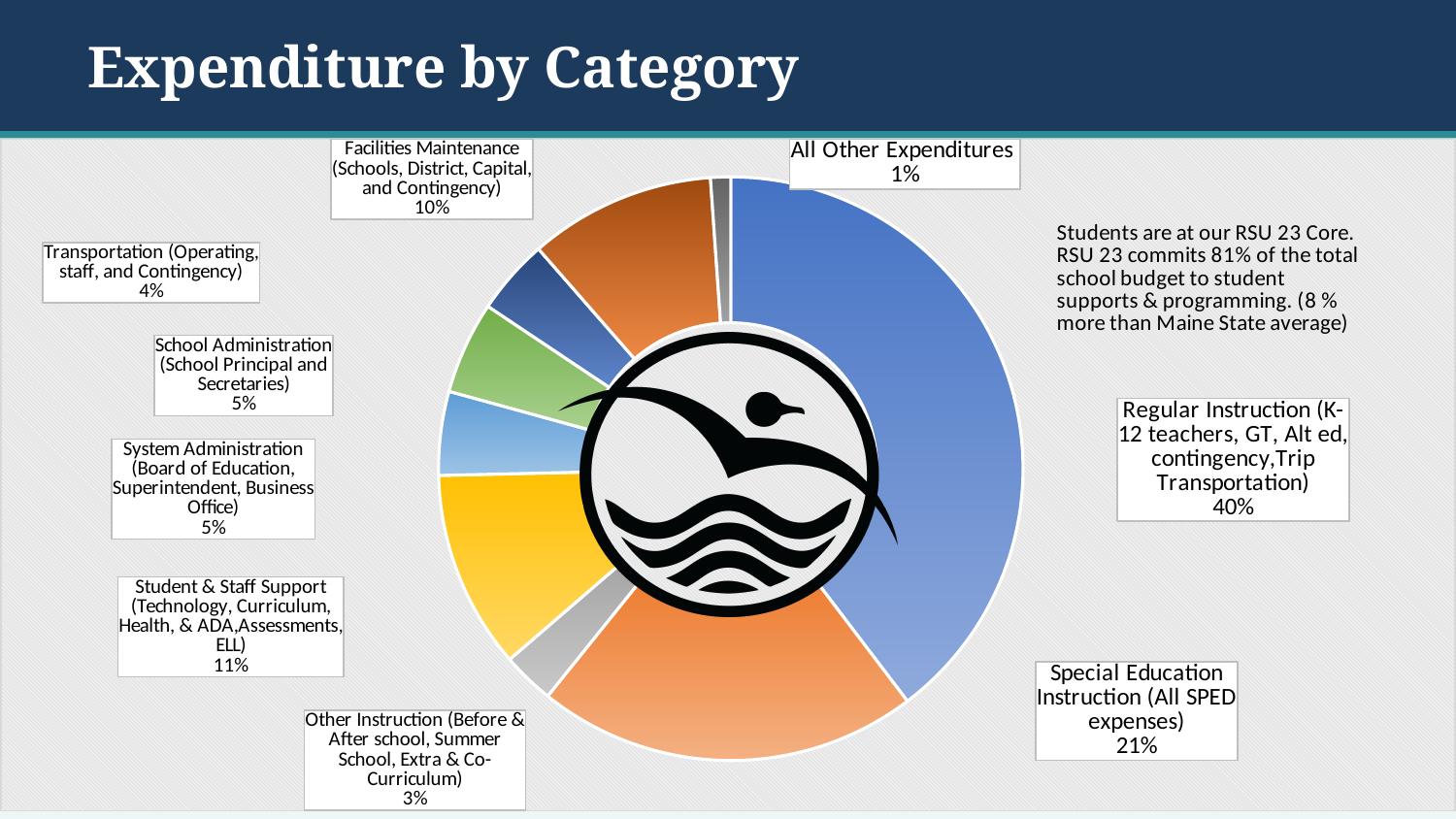
What is the combined percentage of School Administration and System Administration? 10% What kind of chart is shown on the slide? pie chart What percentage is shown for Facilities Maintenance (Schools, District, Capital, and Contingency)? 10% How many categories are shown in the pie chart? 9 Which is larger, the share for Transportation (Operating, staff, and Contingency) or the share for Other Instruction (Before & After school, Summer School, Extra & Co-Curriculum)? Transportation (Operating, staff, and Contingency) What is the title of the slide containing the pie chart? Expenditure by Category What is the difference in percentage points between Regular Instruction and Special Education Instruction? 19 What percentage of expenditure is Special Education Instruction (All SPED expenses)? 21% Which category has the largest share of expenditure? Regular Instruction (K-12 teachers, GT, Alt ed, contingency, Trip Transportation) Which category has the smallest share of expenditure? All Other Expenditures What share of expenditure goes to Regular Instruction (K-12 teachers, GT, Alt ed, contingency, Trip Transportation)? 40% What percentage is shown for Student & Staff Support (Technology, Curriculum, Health, & ADA, Assessments, ELL)? 11%